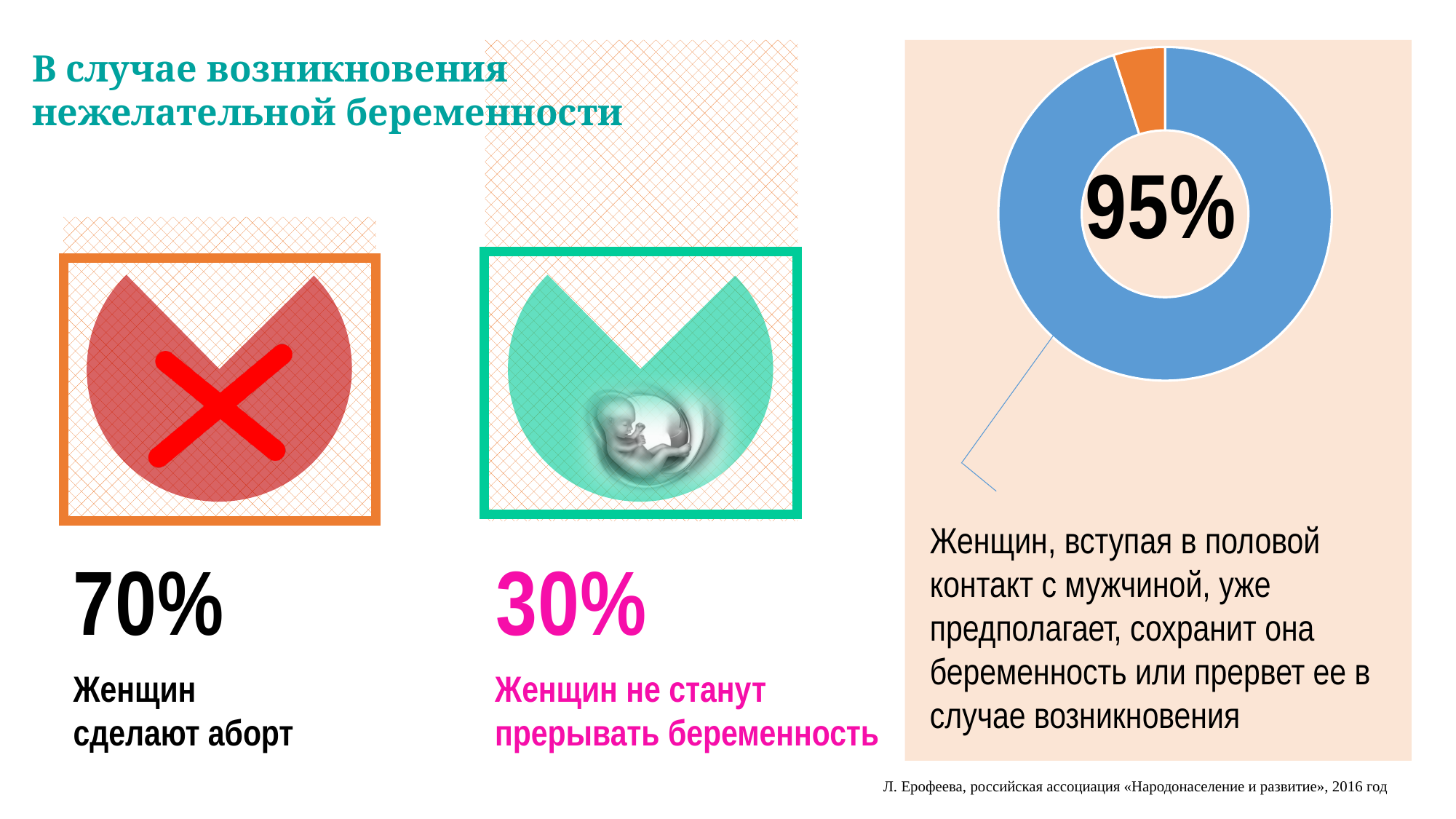
In the left infographic, which group is larger: women who will have an abortion or women who will not terminate the pregnancy? Women who will have an abortion (70%) What is the source cited at the bottom of the slide for the data? Л. Ерофеева, российская ассоциация «Народонаселение и развитие», 2016 год How many segments does the donut chart on the right have? 2 In the donut chart on the right, which colour is the smallest segment? Orange In the left infographic, what percentage of women will not terminate the pregnancy (Женщин не станут прерывать беременность)? 30% In the donut chart on the right, what share does the blue segment represent? 95% What kind of chart is shown on the right side of the slide? Donut chart In the donut chart on the right, what percentage is printed in the centre? 95% What colour is the largest segment of the donut chart on the right? Blue In the left infographic, what percentage of women will have an abortion (Женщин сделают аборт)? 70% In the donut chart on the right, which segment is larger, the blue one or the orange one? Blue In the left infographic, what is the difference between the share of women who will have an abortion and those who will not terminate the pregnancy? 40%